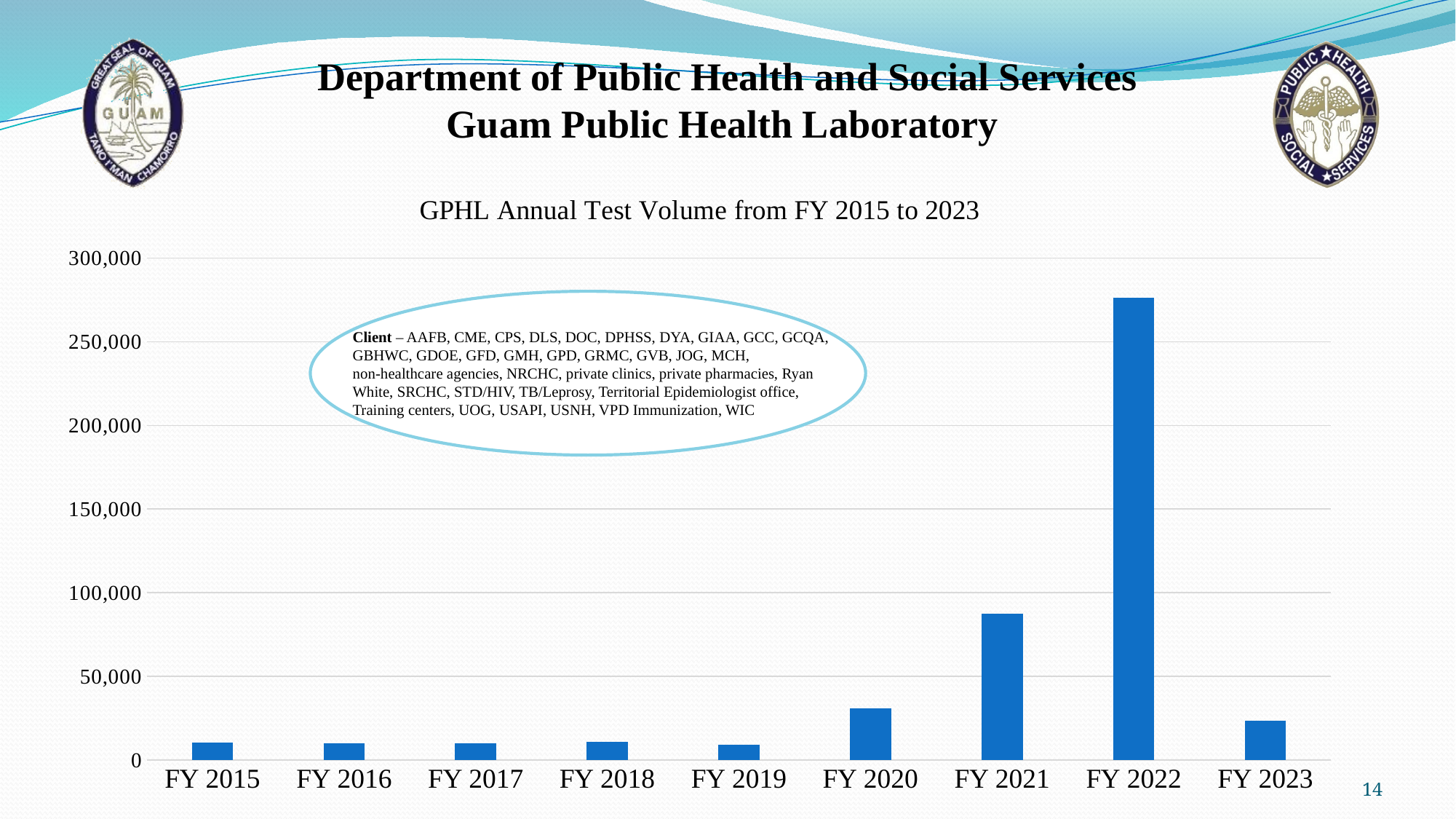
How many fiscal years are plotted on the chart? 9 Is the value for FY 2021 greater or less than 50,000? greater What kind of chart is shown on the slide? Bar chart Is the value for FY 2015 greater or less than 50,000? less Is the value for FY 2022 greater or less than 250,000? greater Which is larger, the value for FY 2021 or the value for FY 2020? FY 2021 Which fiscal year has the highest test volume? FY 2022 Which is larger, the value for FY 2020 or the value for FY 2023? FY 2020 What is the title of the chart? GPHL Annual Test Volume from FY 2015 to 2023 Do the values rise or fall from FY 2019 to FY 2022? Rise